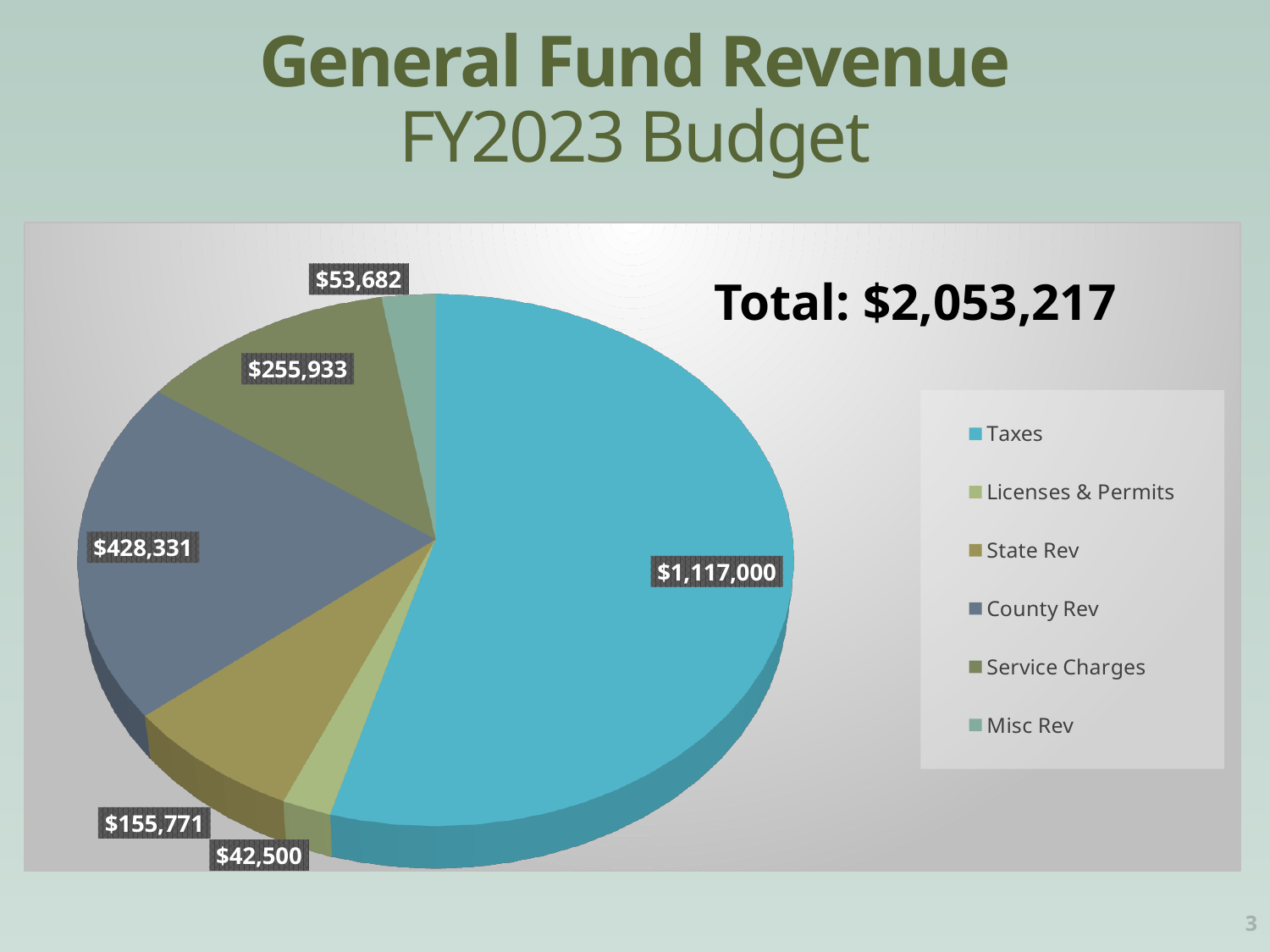
What is the value for State Rev? $155,771 What total is printed on the chart? $2,053,217 How many categories does the pie chart show? 6 What is the difference between County Rev and Service Charges? $172,398 What is the value for Licenses & Permits? $42,500 What is the value for Service Charges? $255,933 Which revenue category is the largest? Taxes What is the value for County Rev? $428,331 Which revenue category is the smallest? Licenses & Permits What kind of chart is shown on the slide? Pie chart Which is larger, Misc Rev or State Rev? State Rev What is the value for Taxes? $1,117,000